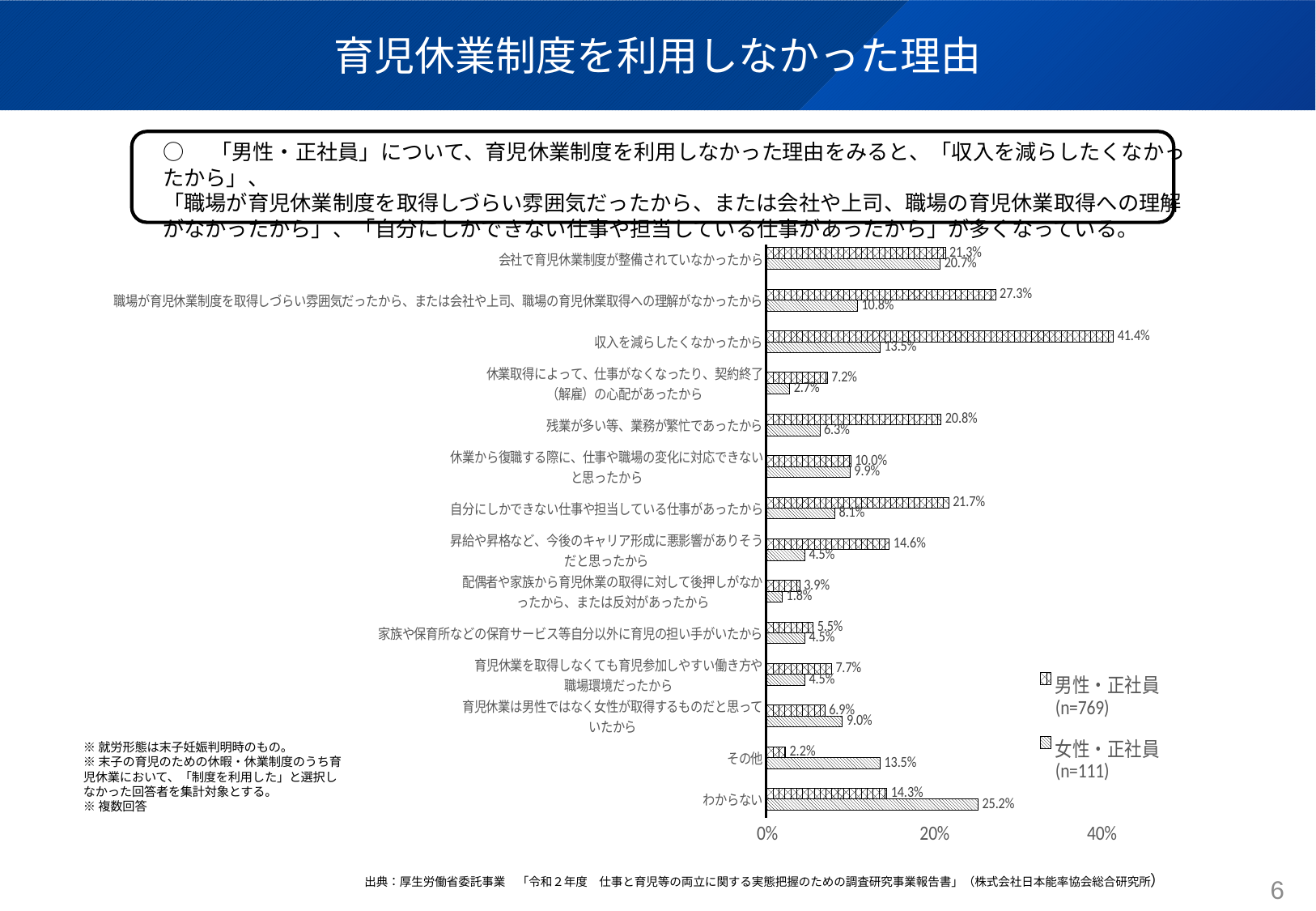
「収入を減らしたくなかったから」の男性・正社員の値は何%ですか？ 41.4% 「その他」の男性・正社員の値は何%ですか？ 2.2% 「わからない」の女性・正社員の値は何%ですか？ 25.2% このグラフの種類は何ですか？ 棒グラフ 「その他」では、男性・正社員と女性・正社員のどちらの値が大きいですか？ 女性・正社員 男性・正社員で最も値が高い理由はどれですか？ 収入を減らしたくなかったから 女性・正社員で最も値が高い項目はどれですか？ わからない 「残業が多い等、業務が繁忙であったから」の男性・正社員の値は20%より大きいですか、小さいですか？ 大きい 「収入を減らしたくなかったから」について、男性・正社員と女性・正社員の差は何ポイントですか？ 27.9ポイント 男性・正社員で最も値が低い項目はどれですか？ その他 このグラフには理由の項目がいくつありますか？ 14 凡例に示されている系列はいくつありますか？ 2